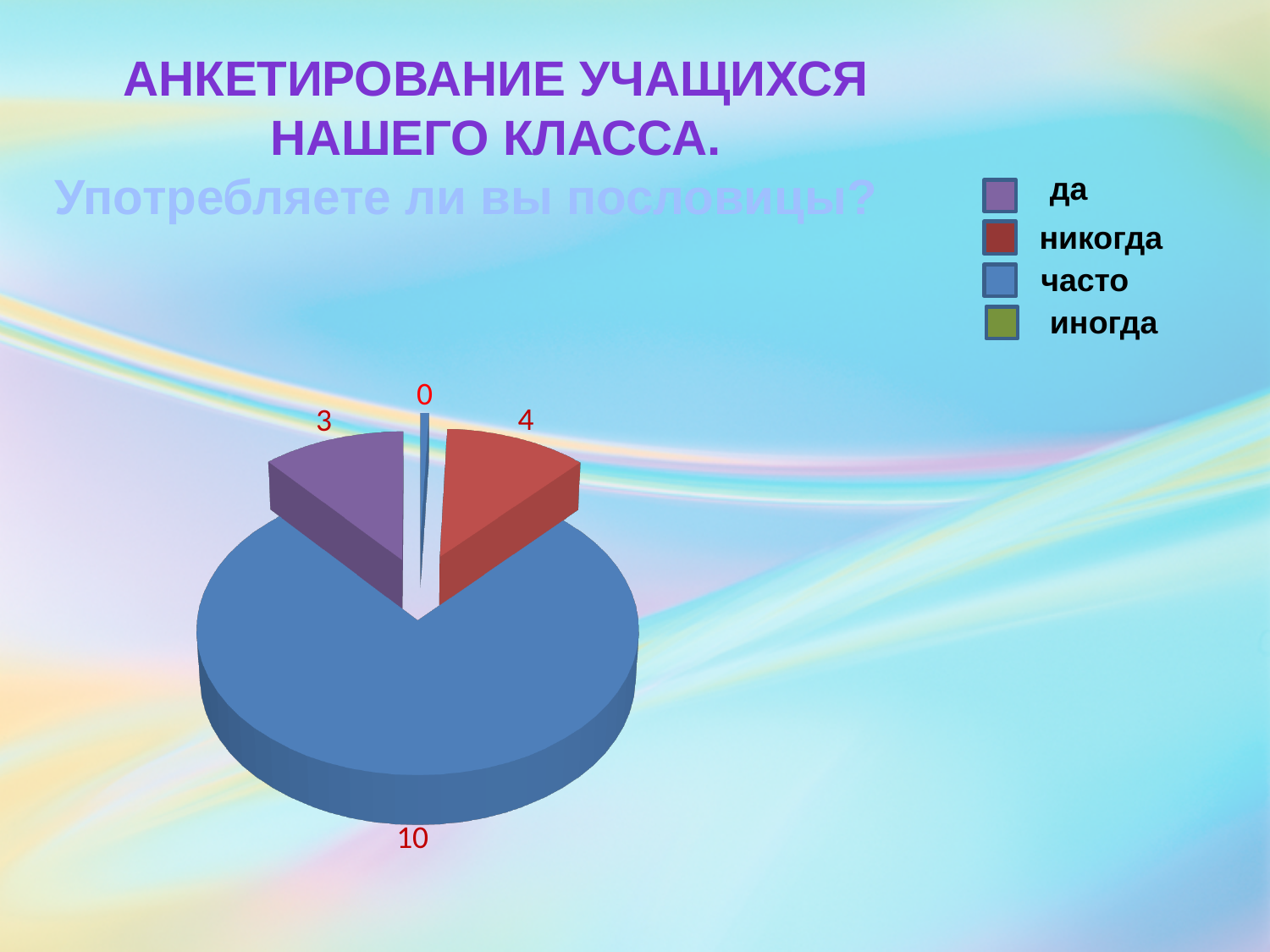
What is the smallest value labelled on the pie? 0 What value is shown for the "да" slice? 3 What is the difference between the values for "часто" and "никогда"? 6 Which category has the largest slice of the pie? часто What colour is the "часто" slice? blue What is the difference between the values for "никогда" and "да"? 1 What kind of chart is shown on the slide? pie chart What question is written above the chart? Употребляете ли вы пословицы? What value is shown for the "часто" slice? 10 Which is larger, the value for "никогда" or the value for "да"? никогда What value is shown for the "никогда" slice? 4 How many categories does the legend list? 4